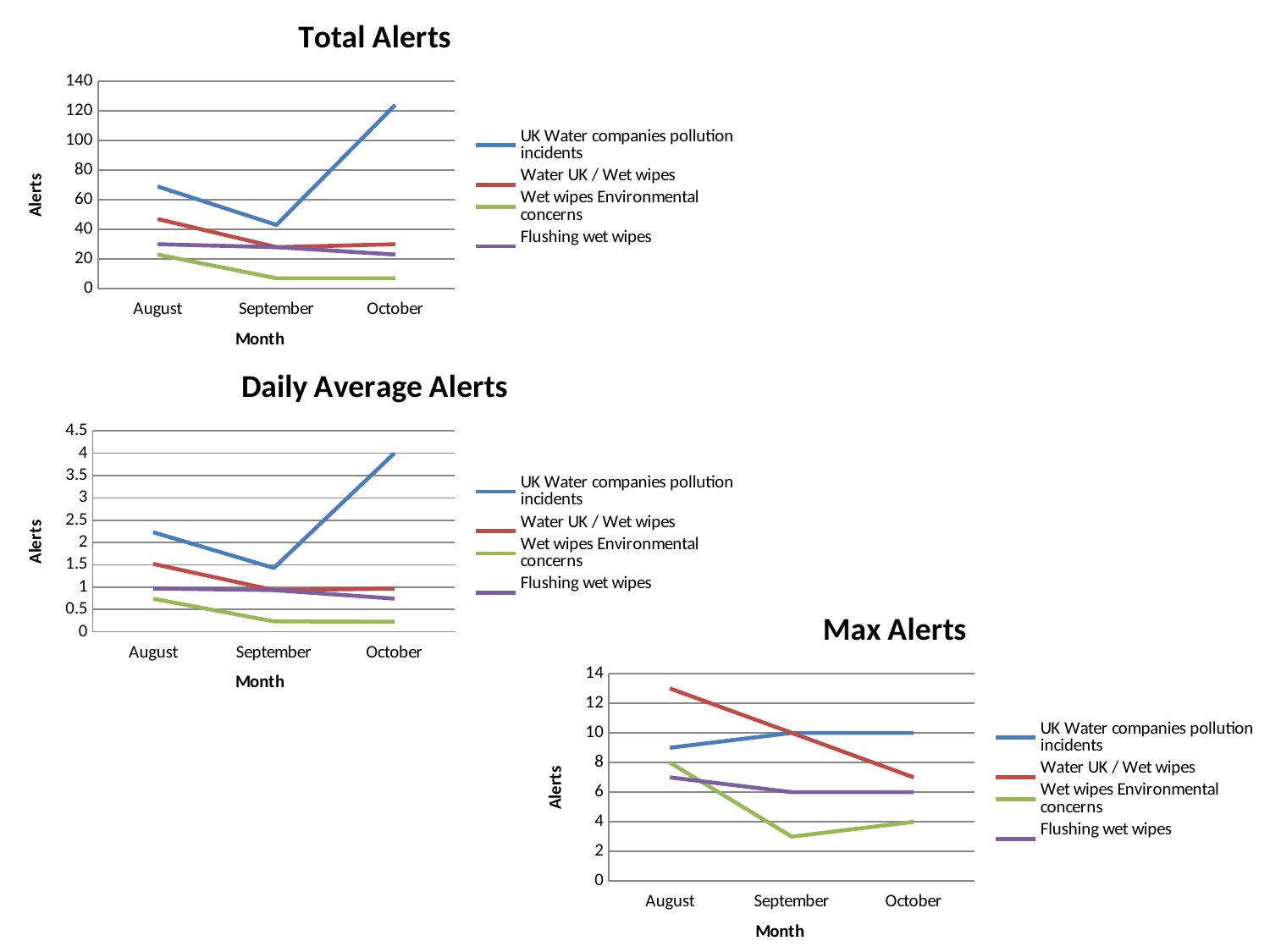
In the Total Alerts chart, which series has the highest value in October? UK Water companies pollution incidents How many months are shown on the x axis of the Daily Average Alerts chart? 3 What type of chart is the Total Alerts chart? line chart How many series does the legend of the Max Alerts chart list? 4 In the Max Alerts chart, which series has the highest value in August? Water UK / Wet wipes In the Daily Average Alerts chart, what is the value for UK Water companies pollution incidents in October? 4 In the Total Alerts chart, is the value for Wet wipes Environmental concerns in September greater or less than 20? less In the Total Alerts chart, is the value for UK Water companies pollution incidents in October greater or less than 100? greater In the Max Alerts chart, what is the value for UK Water companies pollution incidents in October? 10 In the Max Alerts chart, does the Water UK / Wet wipes series rise or fall from August to October? fall In the Max Alerts chart, what is the value for Wet wipes Environmental concerns in August? 8 In the Total Alerts chart, which series has the lowest value in October? Wet wipes Environmental concerns